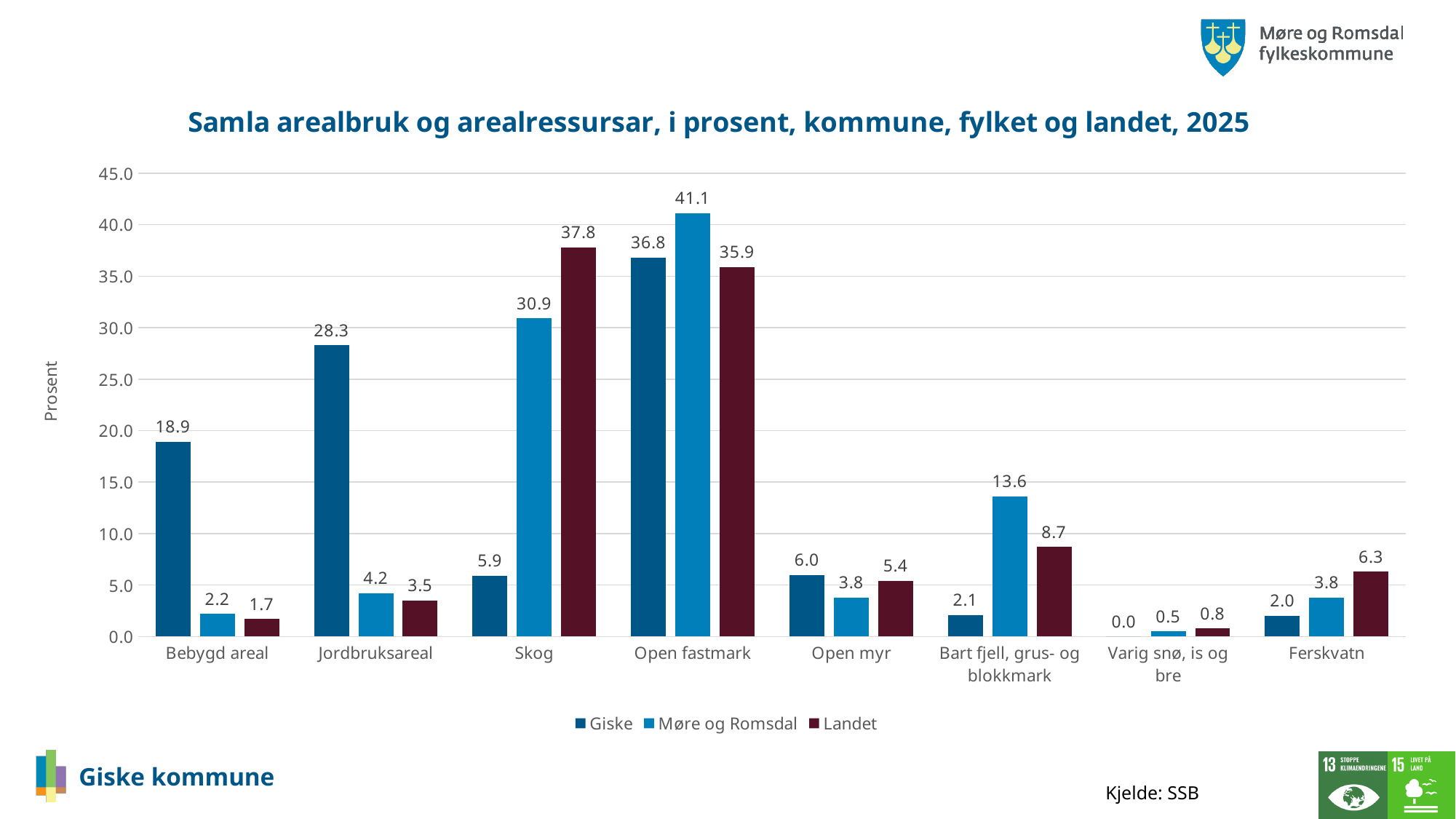
How many series does the legend list? 3 Is the value for Møre og Romsdal in the Skog category greater or less than 30.0? greater Which category has the highest value for Møre og Romsdal? Open fastmark What is the value for Møre og Romsdal in the Bart fjell, grus- og blokkmark category? 13.6 Which category has the lowest value for Giske? Varig snø, is og bre What is the value for Landet in the Skog category? 37.8 What is the title of the chart? Samla arealbruk og arealressursar, i prosent, kommune, fylket og landet, 2025 What kind of chart is shown on the slide? Bar chart How many categories are shown on the x axis? 8 Which is larger for Open myr: the value for Giske or the value for Landet? Giske What is the value for Giske in the Jordbruksareal category? 28.3 What is the difference between the Giske and Landet values for Bebygd areal? 17.2